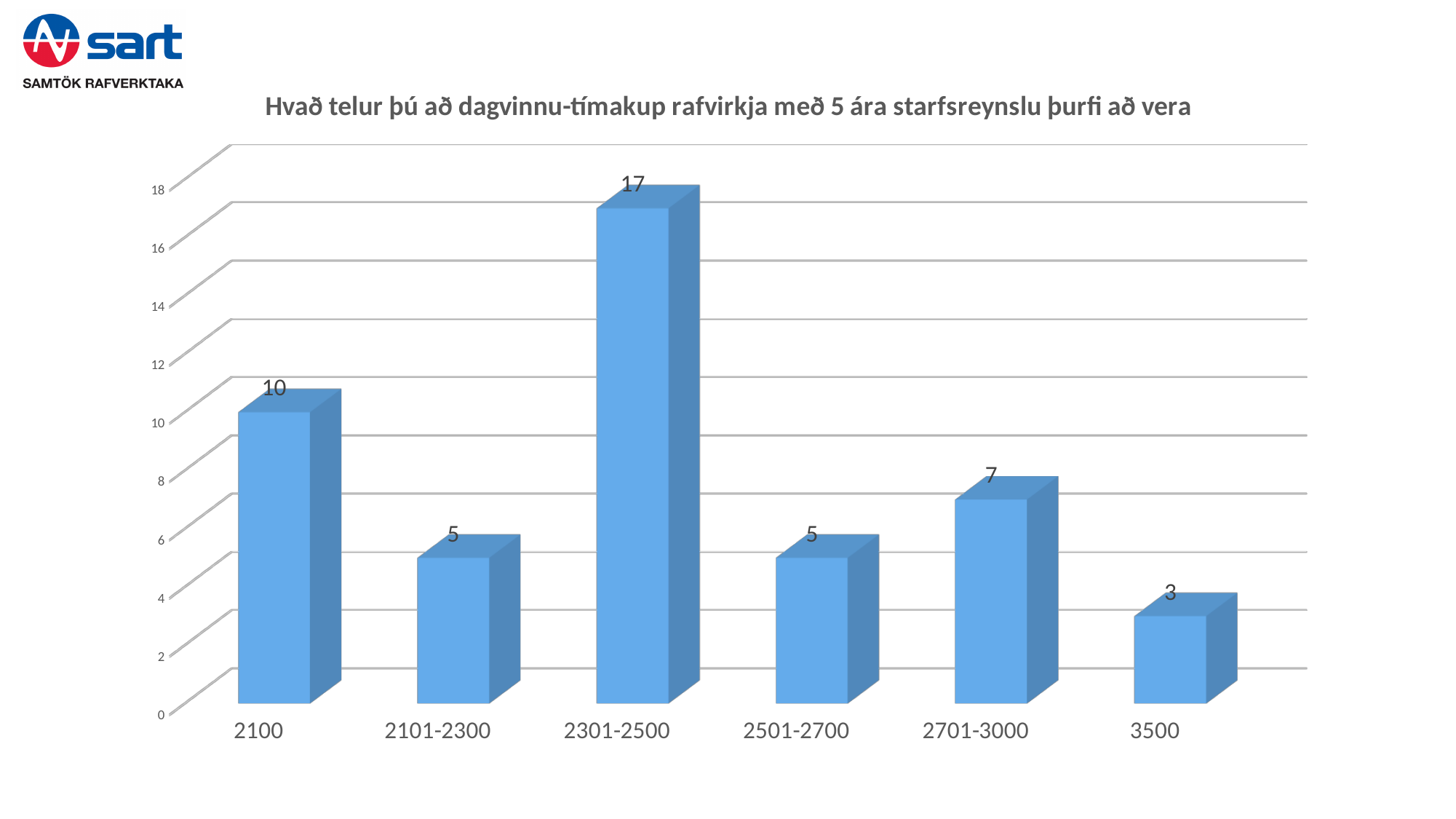
What is the value for the 2100 category? 10 What kind of chart is shown on the slide? Bar chart Which is larger, the value for 2100 or the value for 2701-3000? 2100 What is the value for the 3500 category? 3 How many categories are shown on the x axis? 6 What is the value for the 2701-3000 category? 7 Which category has the highest value? 2301-2500 What is the difference between the values for 2701-3000 and 3500? 4 What is the difference between the values for 2301-2500 and 2100? 7 What is the title of the chart? Hvað telur þú að dagvinnu-tímakup rafvirkja með 5 ára starfsreynslu þurfi að vera Which category has the lowest value? 3500 What is the value for the 2301-2500 category? 17